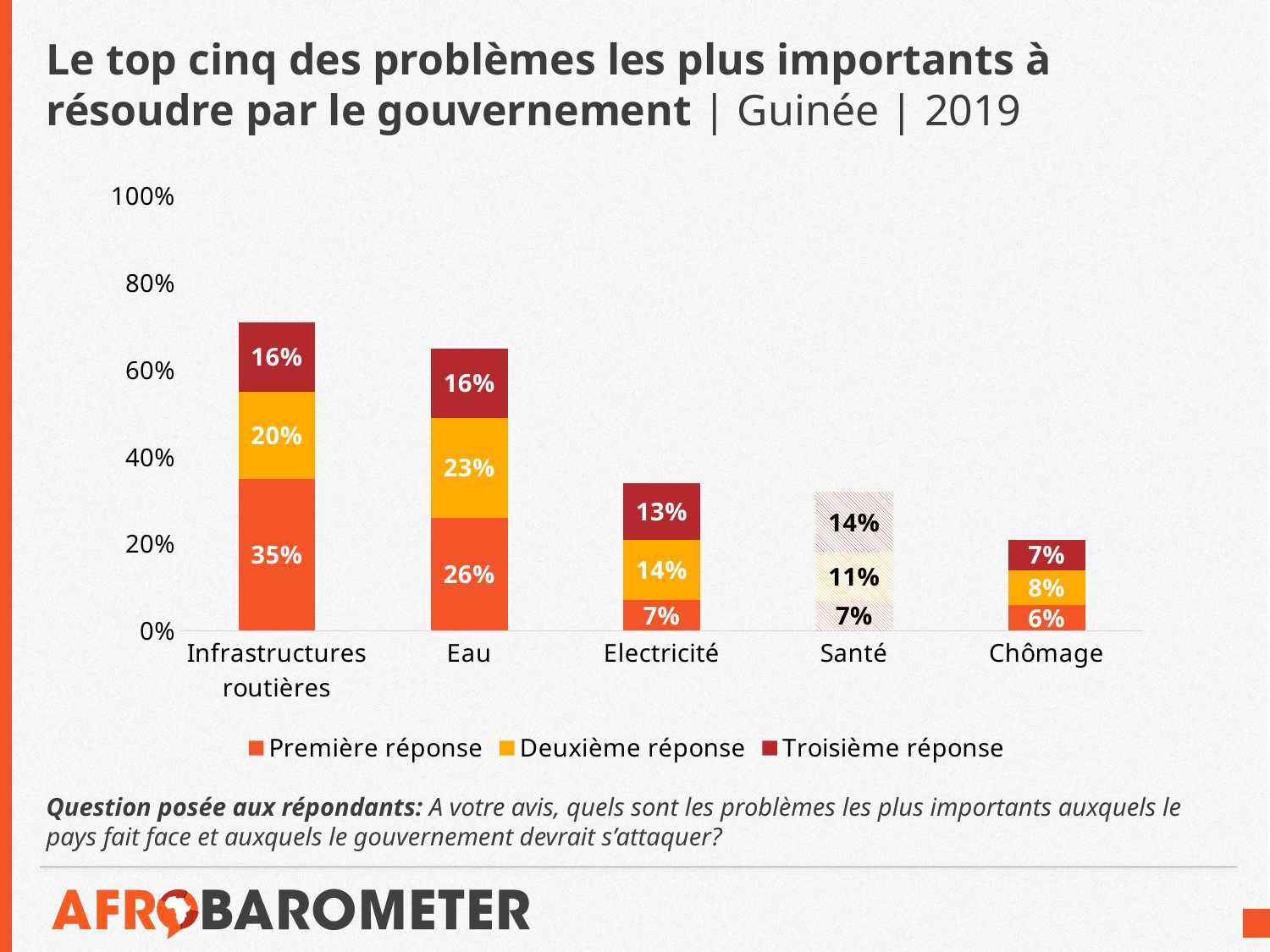
What kind of chart is shown on the slide? Stacked bar chart Which category has the lowest "Première réponse" value? Chômage What is the total of the stacked bar for Chômage? 21% What is the value of "Première réponse" for Infrastructures routières? 35% How many categories are shown on the x axis? 5 Which category has the highest "Première réponse" value? Infrastructures routières What is the total of the stacked bar for Eau? 65% Which is larger: the "Deuxième réponse" value for Electricité or for Santé? Electricité What is the value of "Deuxième réponse" for Eau? 23% What is the value of "Troisième réponse" for Santé? 14% How many series does the legend list? 3 What is the difference between the "Première réponse" values for Infrastructures routières and Eau? 9%